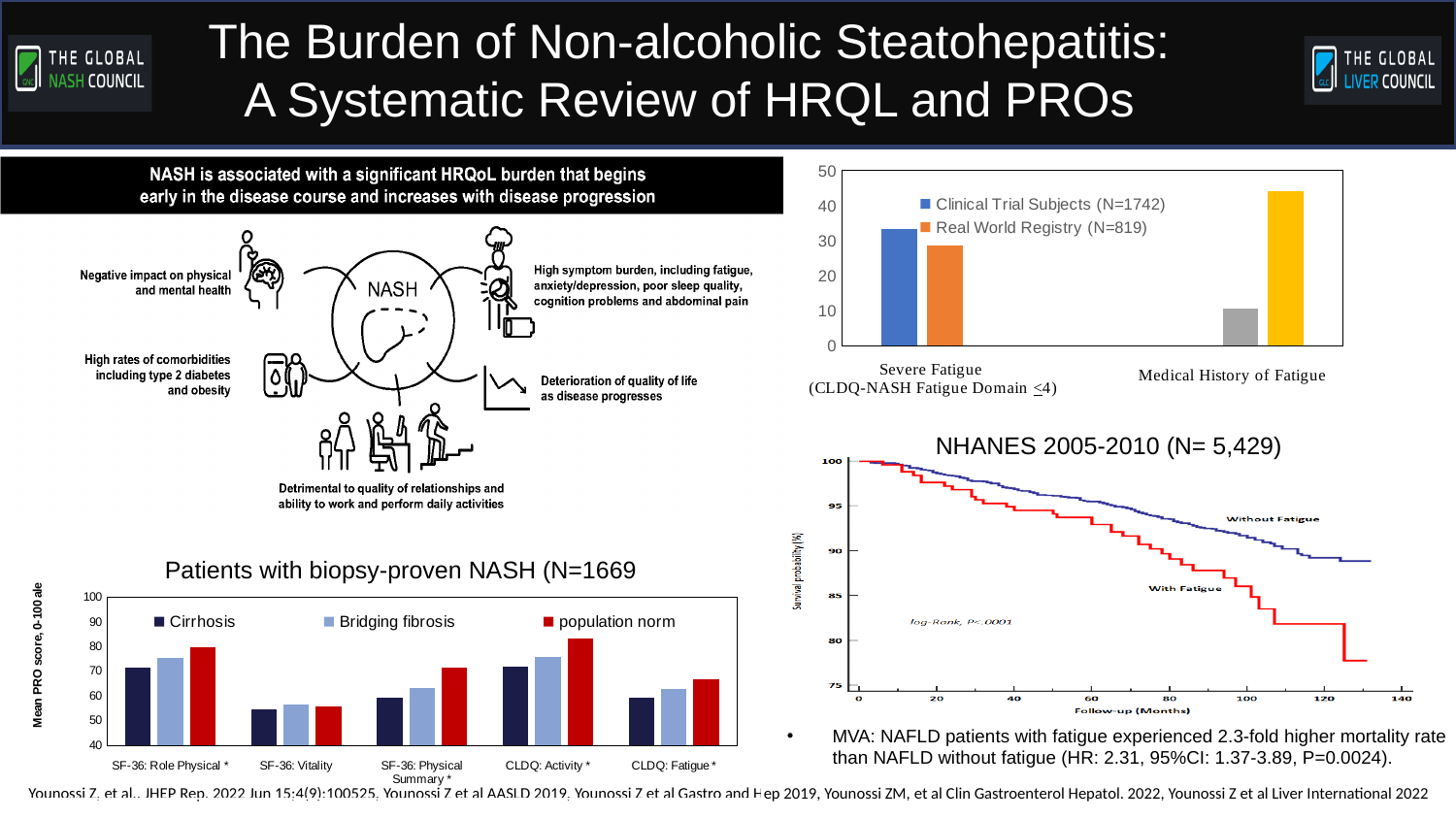
In the 'Patients with biopsy-proven NASH (N=1669)' chart, how many series does the legend list? 3 In the 'Patients with biopsy-proven NASH (N=1669)' chart, how many categories are shown on the x axis? 5 What kind of chart is the 'Patients with biopsy-proven NASH (N=1669)' chart? bar chart In the 'Patients with biopsy-proven NASH (N=1669)' chart, which is larger for SF-36: Physical Summary, Cirrhosis or population norm? population norm In the top-right bar chart, is the yellow bar under Medical History of Fatigue greater or less than 40? greater In the 'Patients with biopsy-proven NASH (N=1669)' chart, what is the y-axis label? Mean PRO score, 0-100 ale In the top-right bar chart, is the value for Clinical Trial Subjects under Severe Fatigue greater or less than 30? greater In the 'Patients with biopsy-proven NASH (N=1669)' chart, is the population norm value for CLDQ: Activity greater or less than 80? greater In the top-right bar chart, how many series does the legend list? 2 In the top-right bar chart, which of the two bars under Medical History of Fatigue is taller, the gray one or the yellow one? the yellow one In the NHANES 2005-2010 chart, do the survival curves rise or fall as follow-up months increase? fall